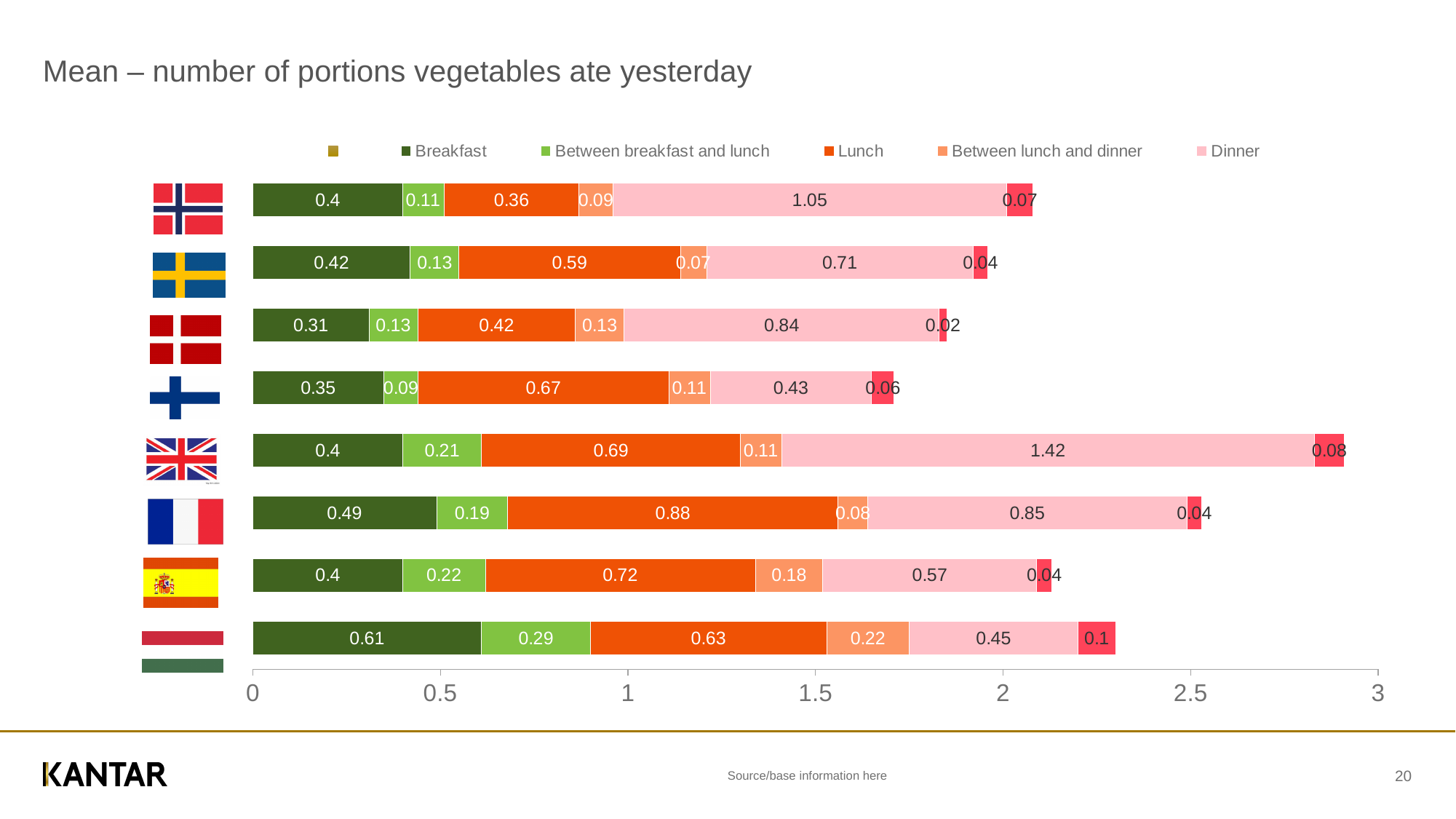
How many bars (countries) are plotted in the chart? 8 Is the total length of the fifth bar from the top greater or less than 2.5? greater How many named series does the legend list? 5 What is the Dinner value for the fifth bar from the top? 1.42 Which is larger: the Lunch value of the fourth bar from the top or the Lunch value of the second bar from the top? The fourth bar from the top (0.67) What is the Between lunch and dinner value for the bottom bar? 0.22 What is the difference between the Dinner value of the fifth bar from the top and the Dinner value of the top bar? 0.37 Which bar has the lowest Breakfast value? The third bar from the top (0.31) What kind of chart is shown on the slide? Stacked bar chart Which bar has the highest Breakfast value? The bottom bar (0.61) What is the title of the chart? Mean – number of portions vegetables ate yesterday What is the total of all segments in the bottom bar? 2.3